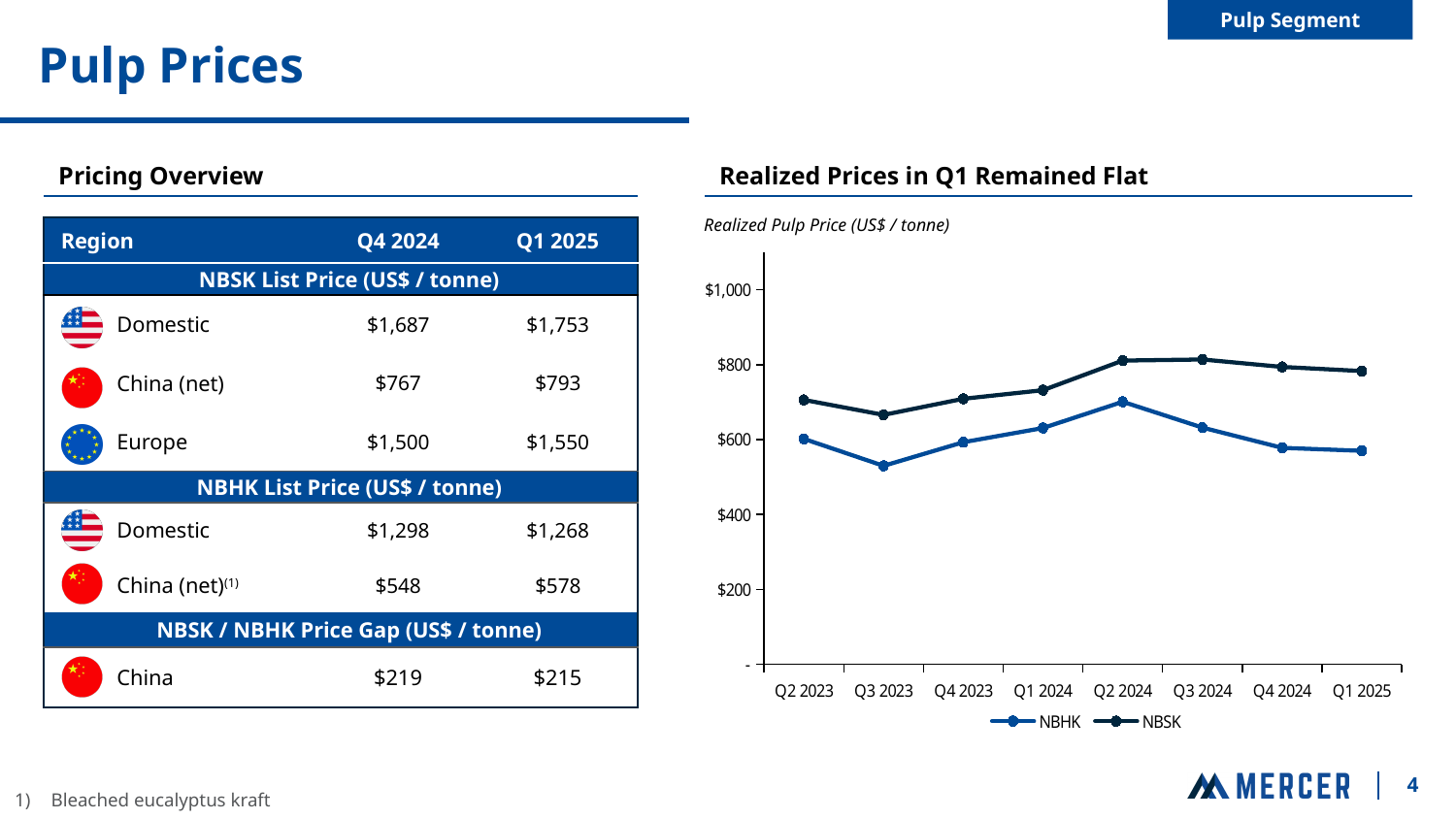
In the realized pulp price chart, which series is higher in Q1 2025, NBHK or NBSK? NBSK Is the NBHK value for Q2 2024 in the realized pulp price chart greater or less than $600? greater In the realized pulp price chart, in which quarter is the NBSK line at its lowest? Q3 2023 How many series does the legend of the realized pulp price chart list? 2 In the realized pulp price chart, does the NBHK line rise or fall from Q2 2024 to Q1 2025? Fall In the realized pulp price chart, in which quarter is the NBHK line at its lowest? Q3 2023 How many quarters are plotted along the x axis of the realized pulp price chart? 8 What kind of chart is shown under "Realized Prices in Q1 Remained Flat"? Line chart Is the NBSK value for Q3 2023 in the realized pulp price chart greater or less than $600? greater Is the NBHK value for Q3 2023 in the realized pulp price chart greater or less than $600? less What unit is given in the italic label above the realized pulp price chart? US$ / tonne In the realized pulp price chart, in which quarter does the NBHK line reach its highest value? Q2 2024